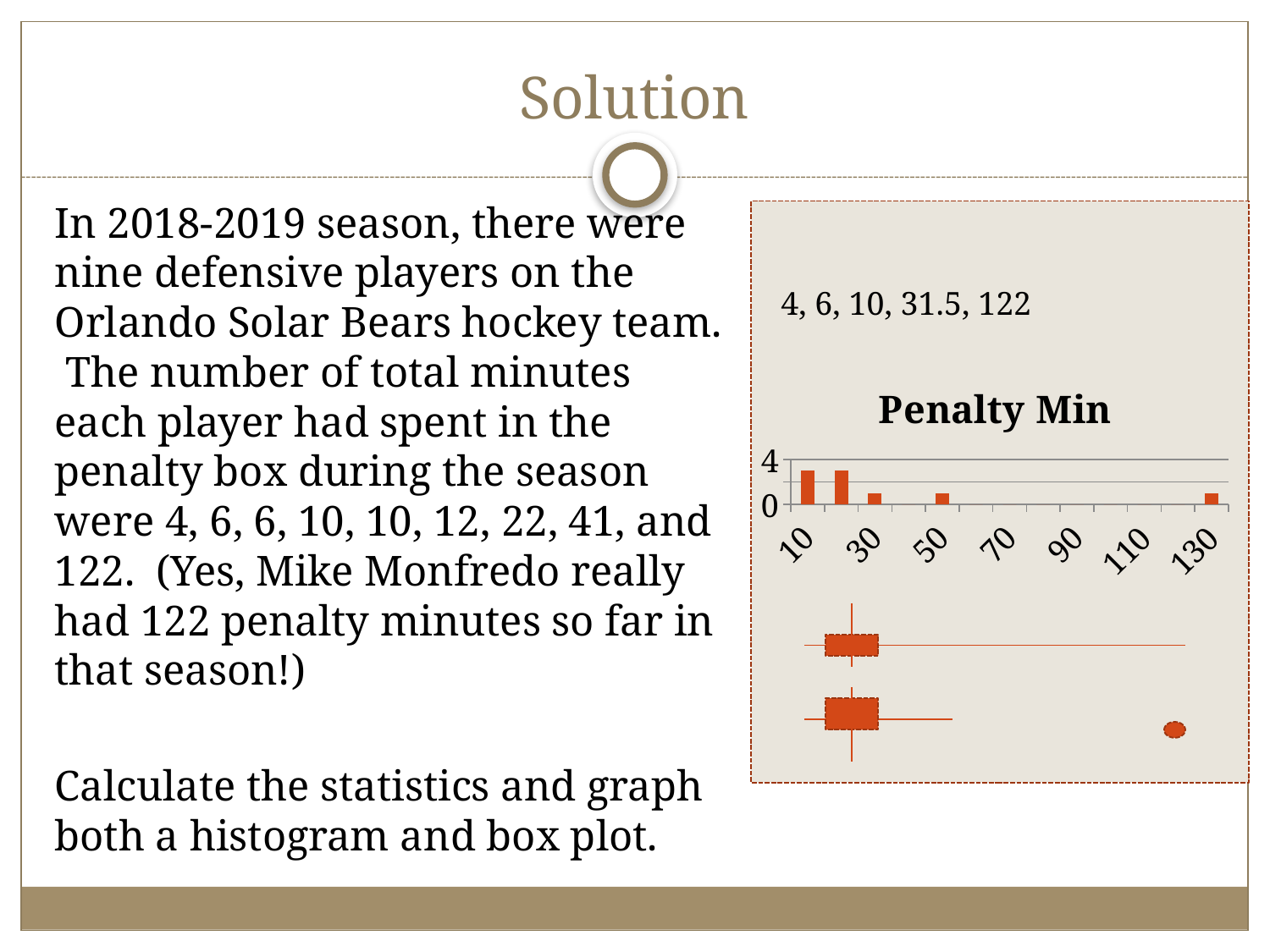
In the 'Penalty Min' chart, how many tick labels are shown on the x axis? 7 What kind of chart is the 'Penalty Min' chart? bar chart In the 'Penalty Min' chart, is the bar at 130 greater or less than 2? less In the 'Penalty Min' chart, what is the lowest value labelled on the x axis? 10 In the 'Penalty Min' chart, how many bars are plotted? 5 In the 'Penalty Min' chart, is the bar at 30 greater or less than 2? less What is the title of the chart on the right side of the slide? Penalty Min In the 'Penalty Min' chart, do the bar heights generally rise or fall moving from left to right along the x axis? fall In the 'Penalty Min' chart, which bar is taller, the one at 50 or the one at 20? 20 In the 'Penalty Min' chart, which bar is taller, the one at 10 or the one at 30? 10 In the 'Penalty Min' chart, what is the highest value labelled on the y axis? 4 In the 'Penalty Min' chart, is the bar at 10 greater or less than 2? greater